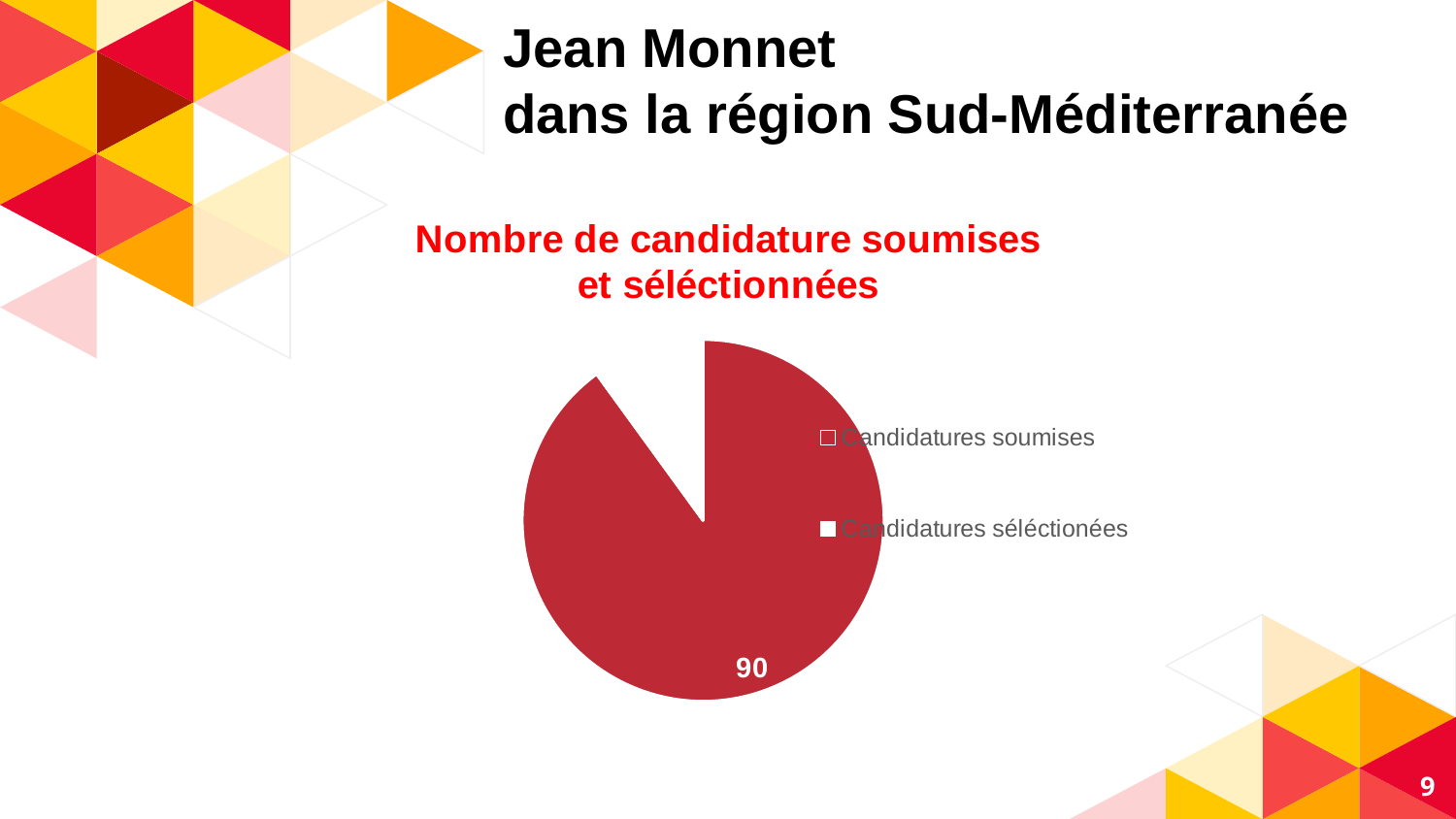
How many categories does the legend of the pie chart list? 2 What is the value shown for Candidatures soumises? 90 Which category has the smallest slice of the pie? Candidatures séléctionées What colour is the slice for Candidatures soumises? red What is the title of the chart? Nombre de candidature soumises et séléctionnées What kind of chart is shown on the slide? pie chart Which category has the largest slice of the pie? Candidatures soumises Which is larger, Candidatures soumises or Candidatures séléctionées? Candidatures soumises